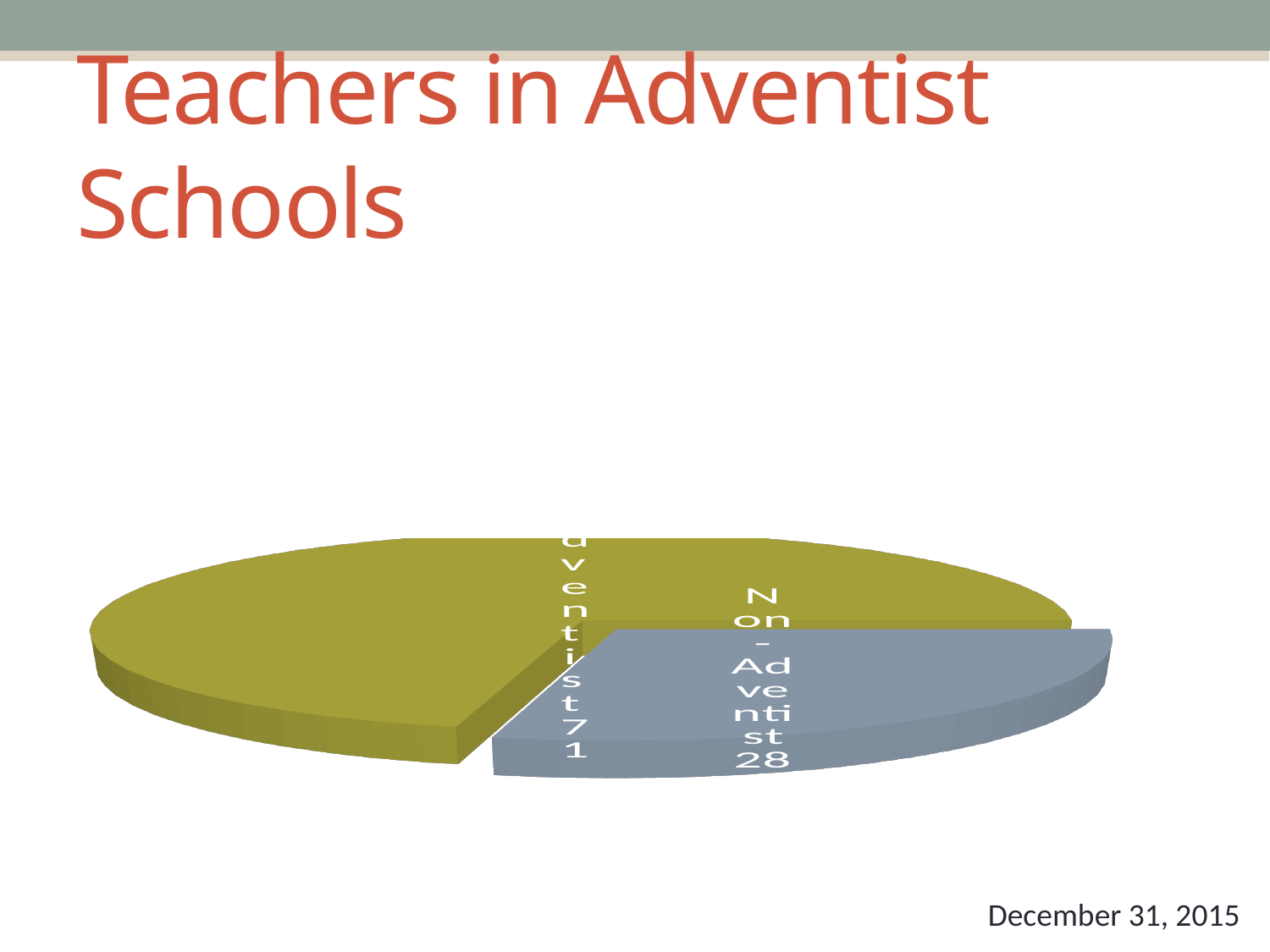
What is the title of the slide containing the pie chart? Teachers in Adventist Schools How many slices does the pie chart have? 2 What kind of chart is shown on the slide? pie chart What colour is the Non-Adventist slice of the pie chart? grey-blue Which is larger, the Adventist value or the Non-Adventist value? Adventist What is the value shown for the Adventist slice? 71 What is the value shown for the Non-Adventist slice? 28 Which slice of the pie is the largest? Adventist Which slice of the pie is the smallest? Non-Adventist What is the sum of the two values shown on the pie chart? 99 What is the difference between the Adventist value and the Non-Adventist value? 43